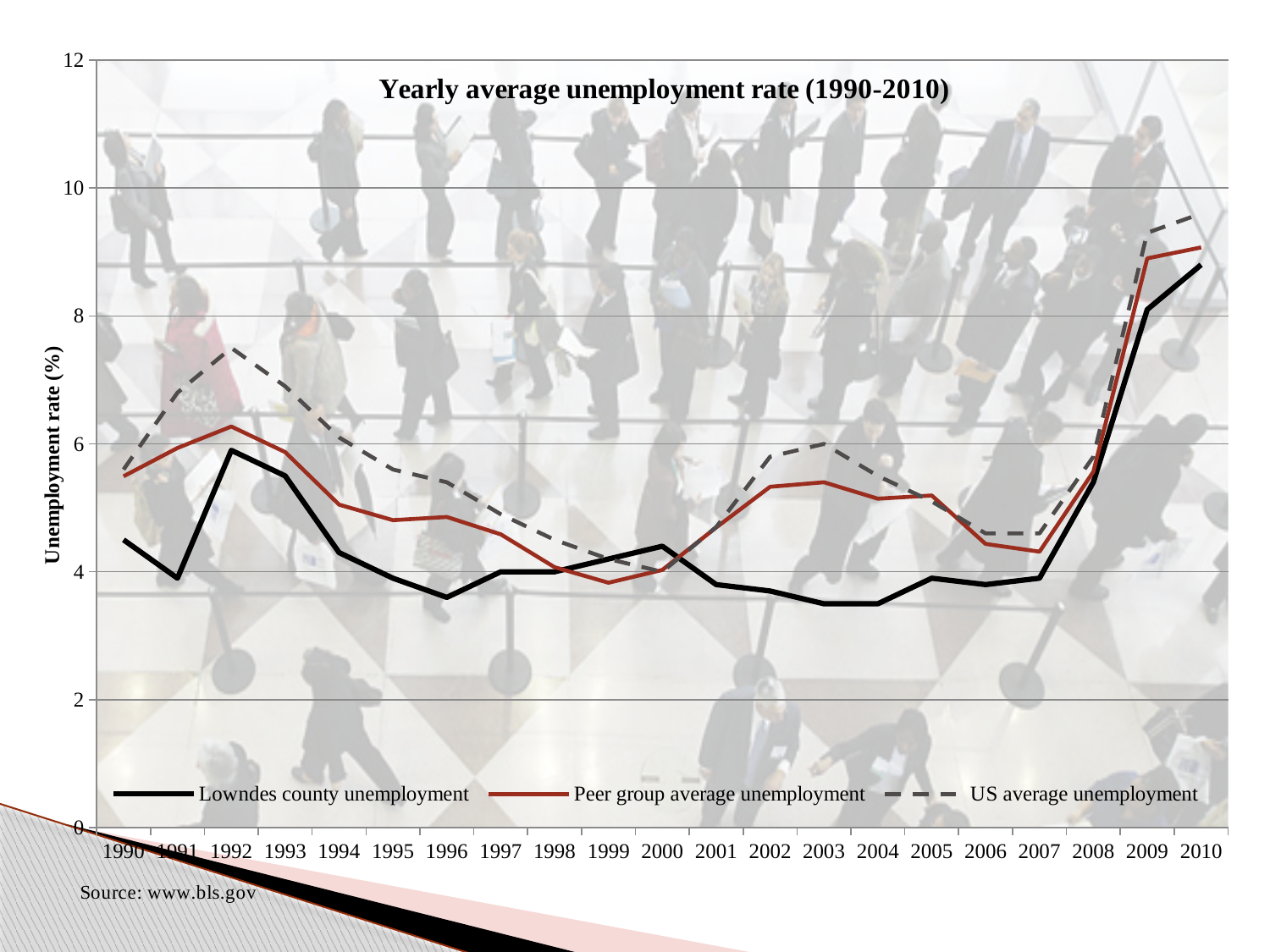
In 1996, which is higher: Lowndes county unemployment or Peer group average unemployment? Peer group average unemployment How many series does the legend list? 3 Is the Peer group average unemployment value for 2009 greater or less than 8? greater In which year is Lowndes county unemployment at its highest? 2010 Is the Lowndes county unemployment value for 2003 greater or less than 4? less What is the label on the vertical axis? Unemployment rate (%) Is the US average unemployment value for 1992 greater or less than 6? greater How many years are plotted along the x axis? 21 What kind of chart is shown on the slide? line chart What is the title of the chart? Yearly average unemployment rate (1990-2010) In 1992, which is higher: Lowndes county unemployment or US average unemployment? US average unemployment